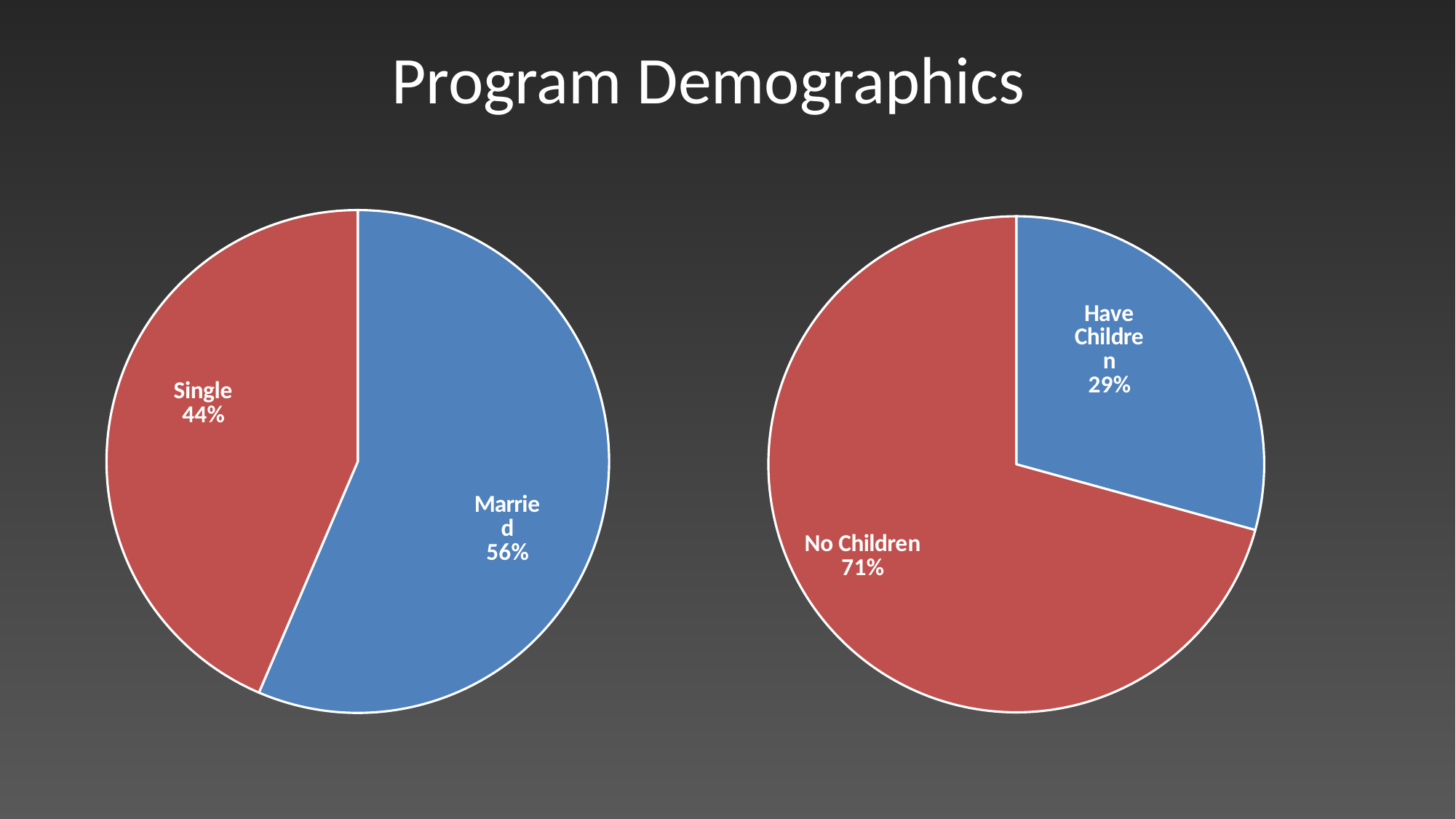
In the left pie chart, what share is labelled Married? 56% In the right pie chart, what share is labelled No Children? 71% What type of chart is shown on the left of the slide? Pie chart In the left pie chart, which is larger, Single or Married? Married In the left pie chart, what is the difference in percentage points between Married and Single? 12 In the left pie chart, what share is labelled Single? 44% What is the title of the slide containing the two pie charts? Program Demographics In the right pie chart, which slice is the smallest? Have Children How many slices does the right pie chart have? 2 In the right pie chart, what is the difference in percentage points between No Children and Have Children? 42 In the left pie chart, which slice is the largest? Married